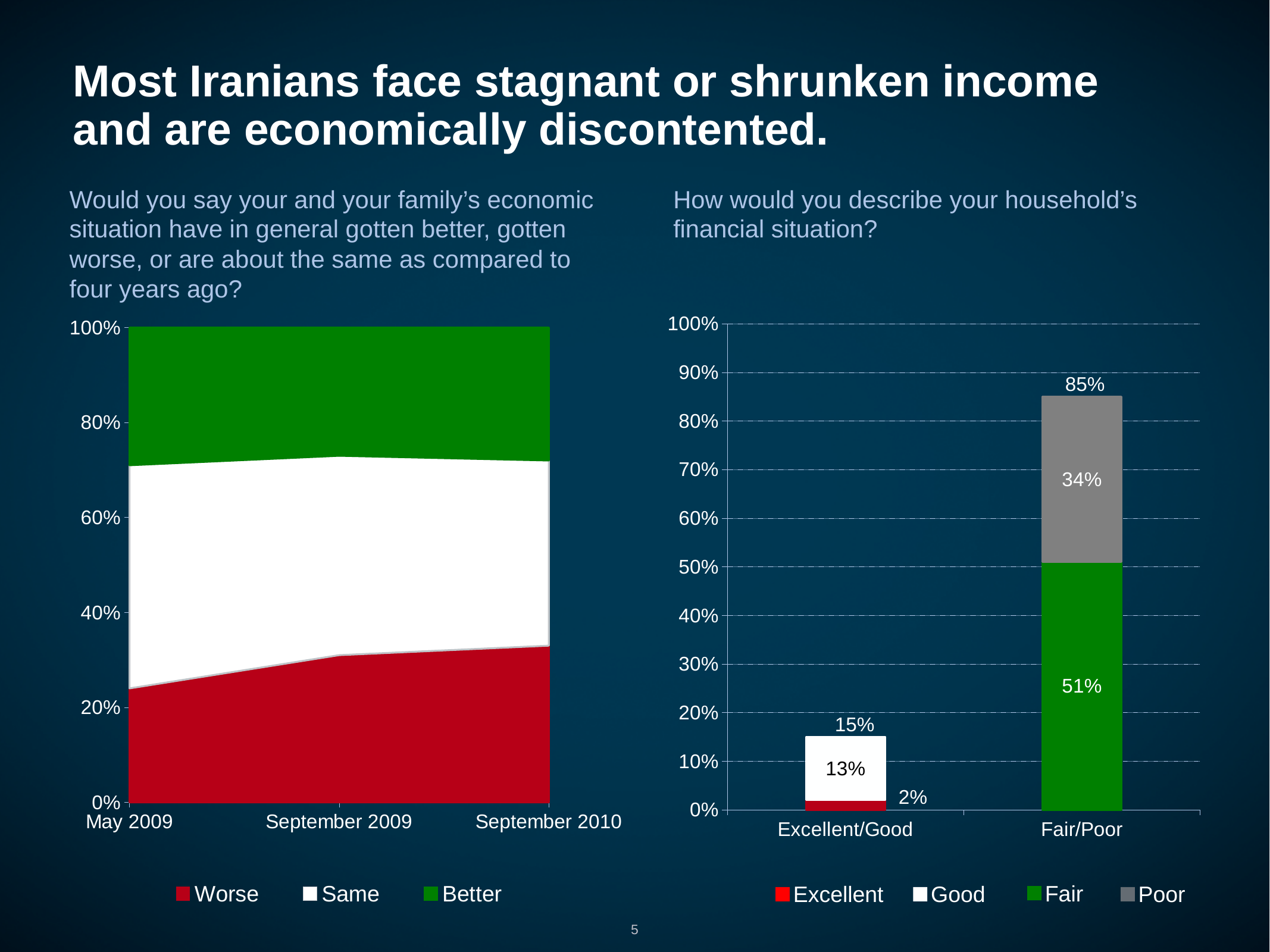
In the right chart, what is the difference between the Fair/Poor total and the Excellent/Good total? 70 percentage points How many time points are shown on the x axis of the left chart? 3 In the right chart, what is the value for Good in the Excellent/Good bar? 13% What kind of chart is the left chart (economic situation compared to four years ago)? Stacked area chart In the right chart, what is the value for Poor in the Fair/Poor bar? 34% In the right chart, which bar is taller, Excellent/Good or Fair/Poor? Fair/Poor In the left chart, does the Worse share rise or fall from May 2009 to September 2010? rise In the right chart, what is the total of the Fair/Poor stacked bar? 85% In the right chart (How would you describe your household's financial situation?), what is the value for Fair in the Fair/Poor bar? 51% In the left chart, is the value for Worse in May 2009 greater or less than 30%? less How many series does the legend of the right chart list? 4 In the right chart, what is the value for Excellent in the Excellent/Good bar? 2%